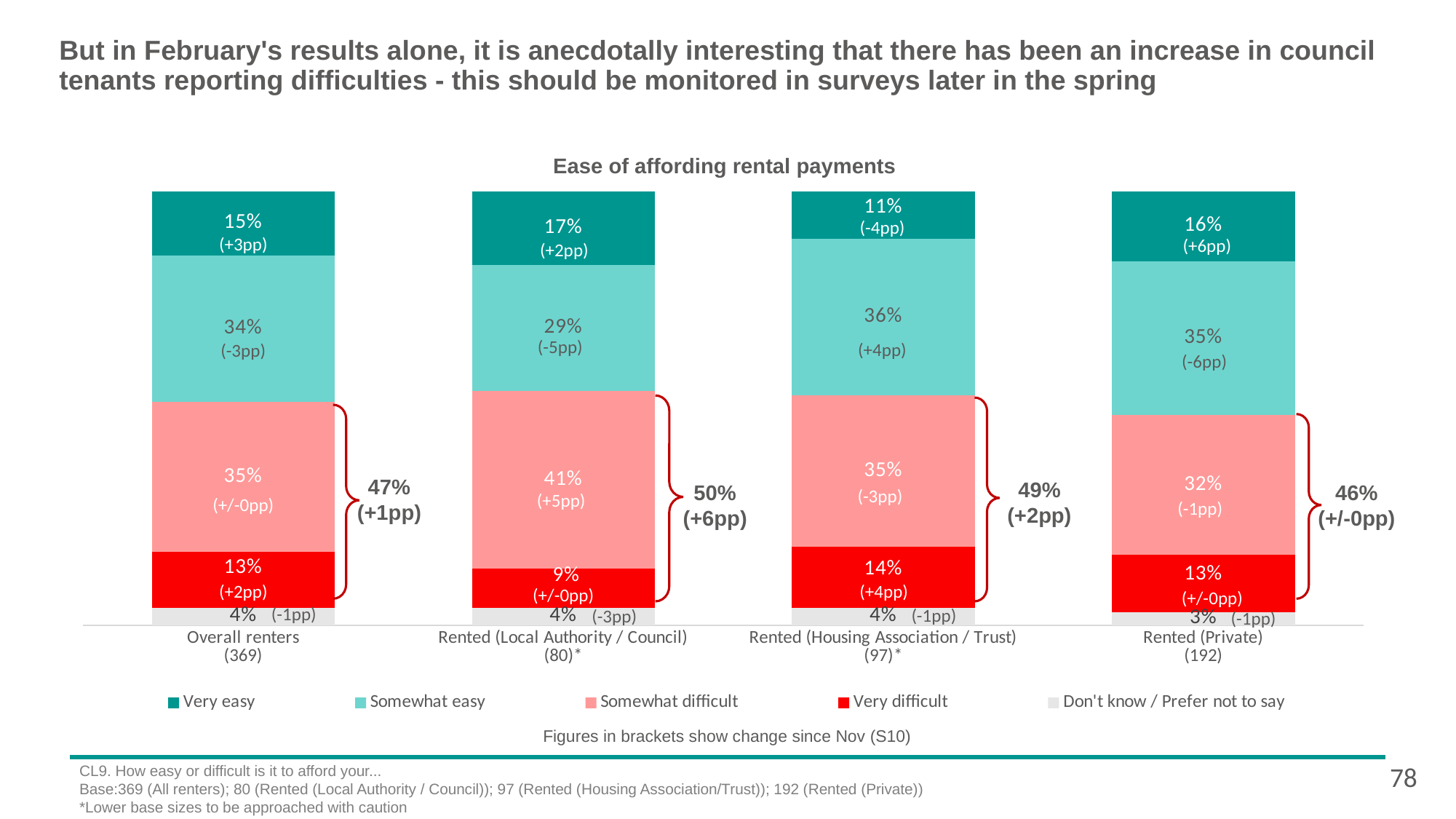
Which category has the highest percentage for Somewhat difficult? Rented (Local Authority / Council) What is the difference between the Somewhat easy percentages for Rented (Housing Association / Trust) and Rented (Local Authority / Council)? 7 percentage points How many series does the legend list? 5 What percentage of Rented (Housing Association / Trust) respondents said it is very difficult? 14% How many categories are shown on the x axis? 4 What is the title of the chart? Ease of affording rental payments What is the combined percentage of Somewhat difficult and Very difficult for Rented (Private), as shown by the bracket? 46% What percentage of Rented (Local Authority / Council) respondents said it is somewhat difficult to afford rental payments? 41% Which category has the lowest percentage for Very easy? Rented (Housing Association / Trust) Which is larger: the Very difficult percentage for Overall renters or for Rented (Local Authority / Council)? Overall renters What percentage of Rented (Private) respondents said it is very easy? 16% What kind of chart is shown on the slide? Stacked bar chart